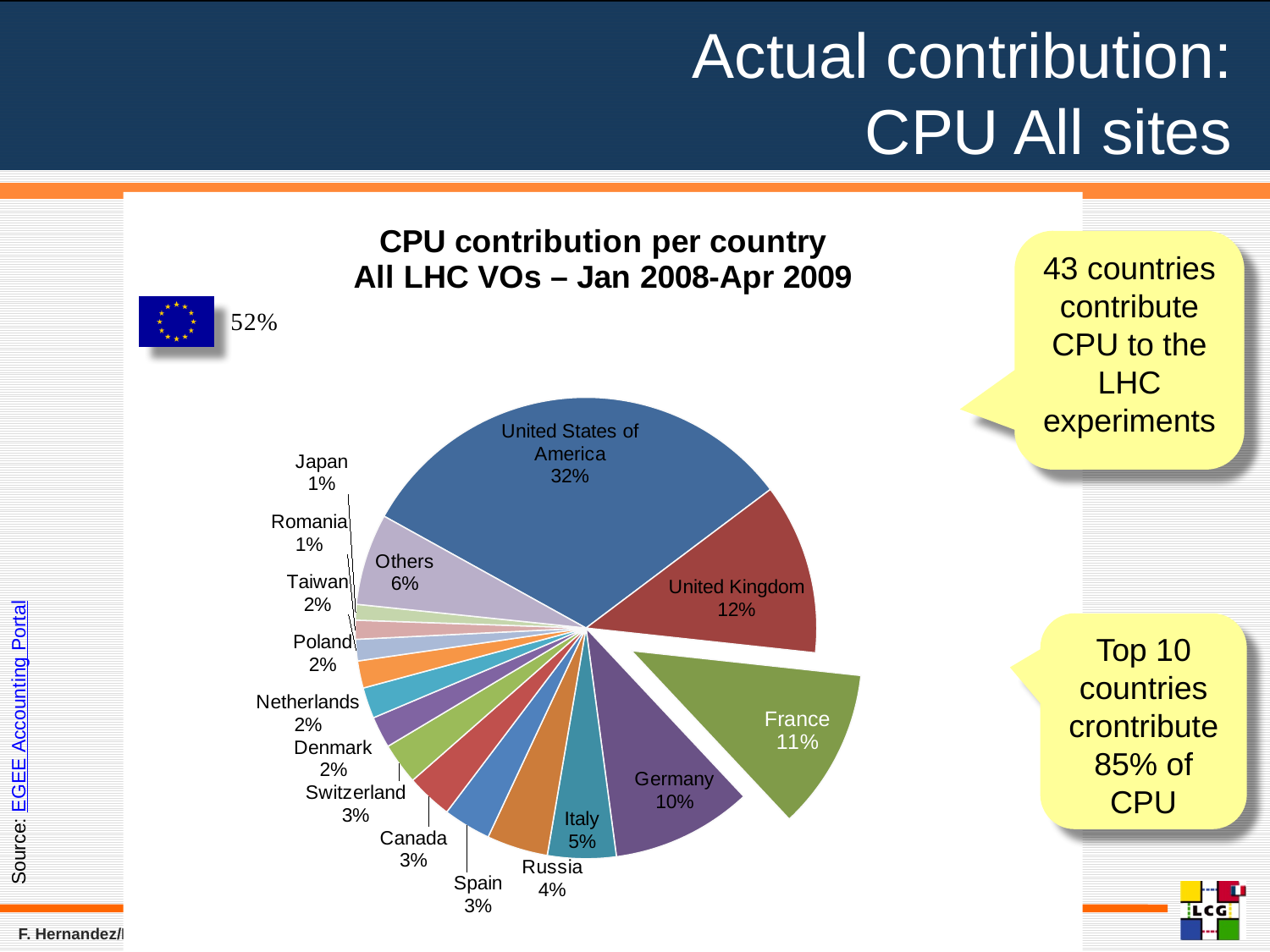
What is the title of the chart? CPU contribution per country All LHC VOs – Jan 2008-Apr 2009 What type of chart is shown on the slide? pie chart What is the value shown for the United Kingdom? 12% Which has a larger share, Italy or Russia? Italy What share of CPU contribution does the United States of America account for? 32% What is the value shown for Russia? 4% What is the value shown for France? 11% What is the value shown for Germany? 10% What is the difference between the shares of the United States of America and the United Kingdom? 20% Which country has the largest share of CPU contribution? United States of America What is the difference between the shares of France and Germany? 1% What is the value shown for the Others slice? 6%